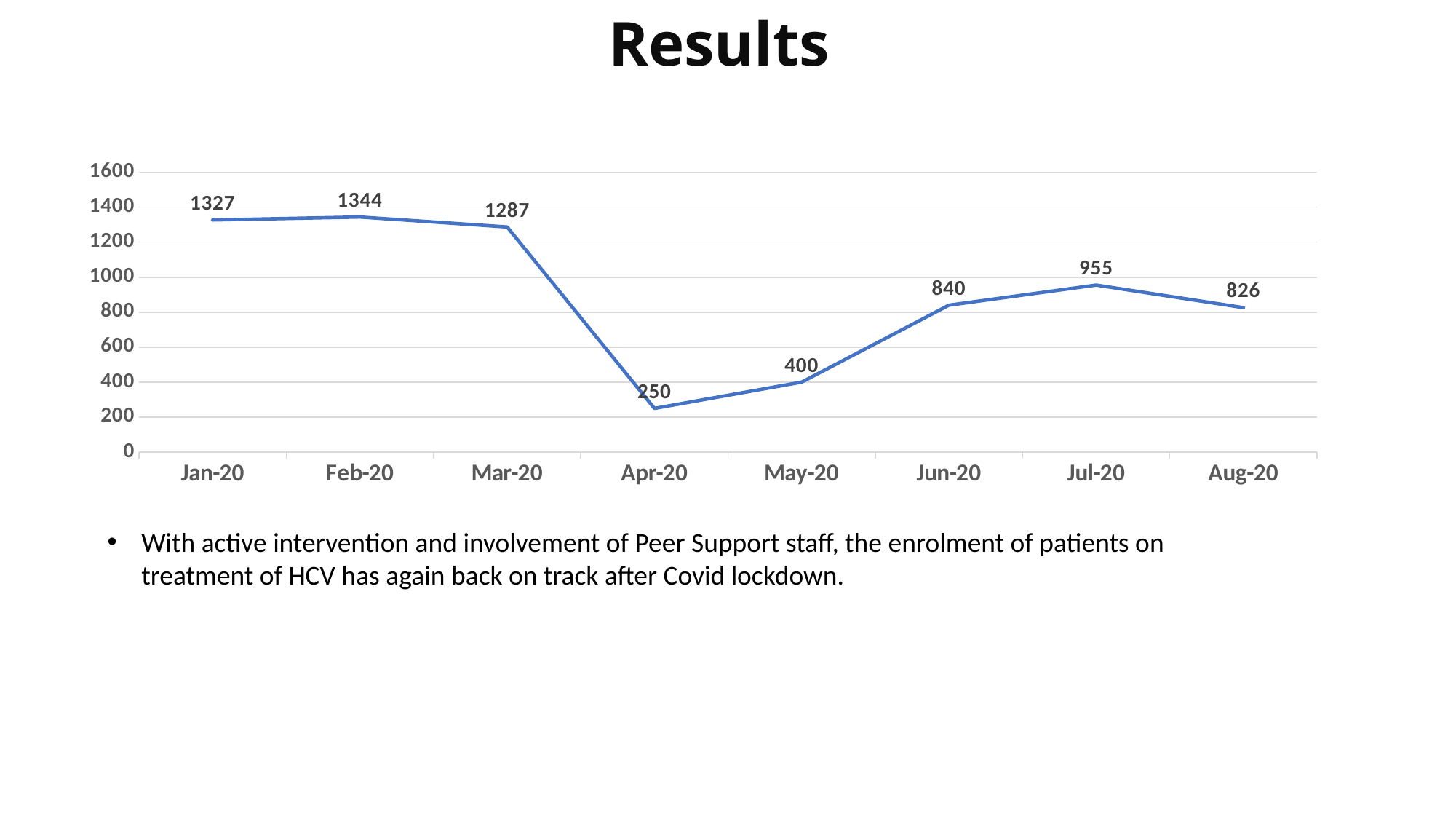
How many months are plotted on the x axis? 8 Which month has the highest value? Feb-20 What is the value for Jul-20? 955 Which is larger, the value for Jun-20 or the value for May-20? Jun-20 Which month has the lowest value? Apr-20 Do the values rise or fall from Apr-20 to Jul-20? rise What is the difference between the values for Mar-20 and Apr-20? 1037 Is the value for May-20 greater or less than 600? less What is the value for Jan-20? 1327 What is the value for Apr-20? 250 What kind of chart is shown on the slide? line chart What is the difference between the values for Jul-20 and Aug-20? 129